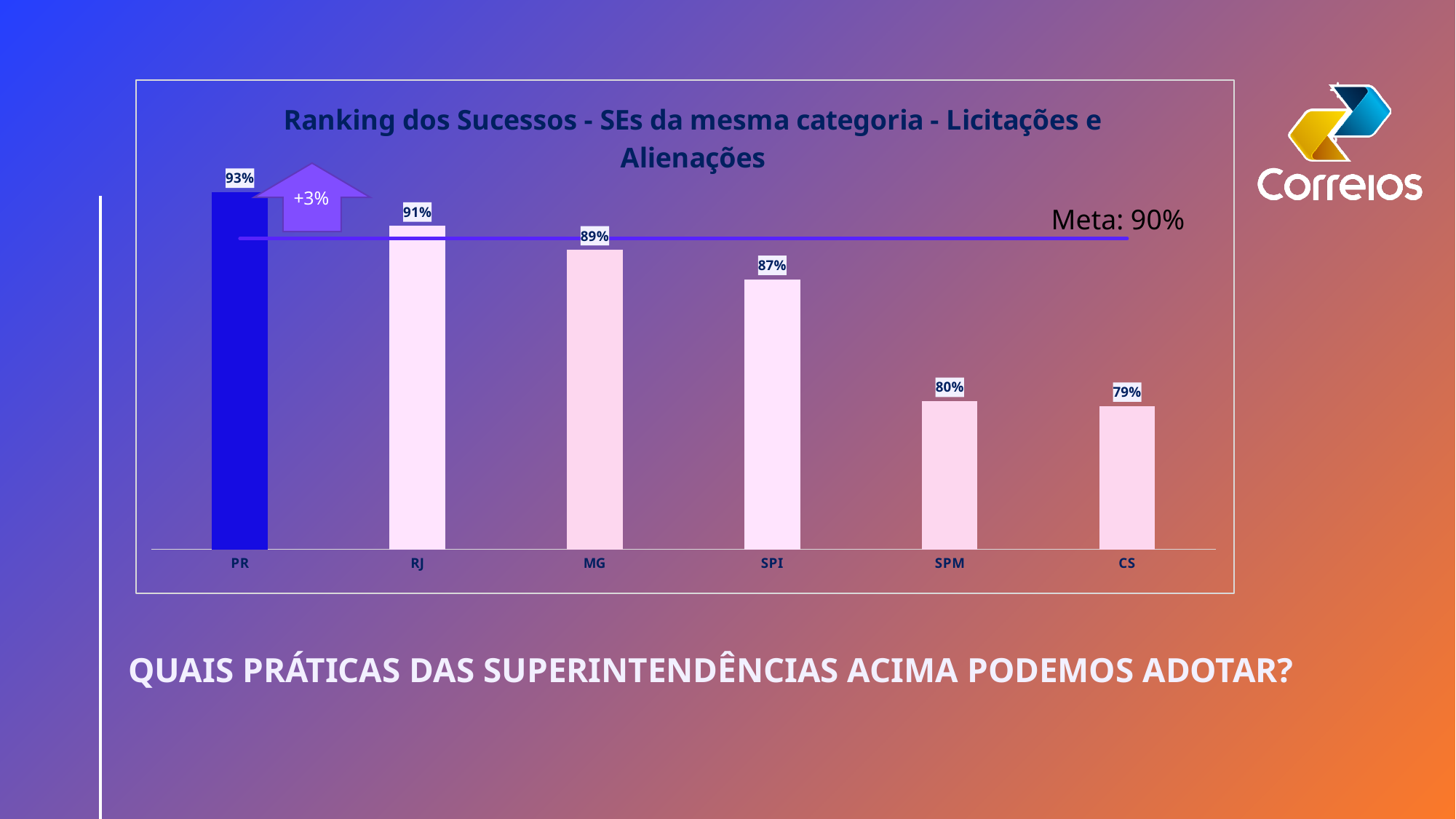
What kind of chart is this? Bar chart What is the value for PR? 93% Which is larger, the value for RJ or the value for MG? RJ Which category has the lowest value? CS Do the values rise or fall from left to right along the x axis? Fall What is the value for CS? 79% How many categories are shown on the x axis? 6 Which category has the highest value? PR What target value (Meta) is marked by the horizontal line on the chart? 90% What is the value for SPI? 87% What is the difference between the values for PR and RJ? 2% What is the difference between the values for MG and SPM? 9%